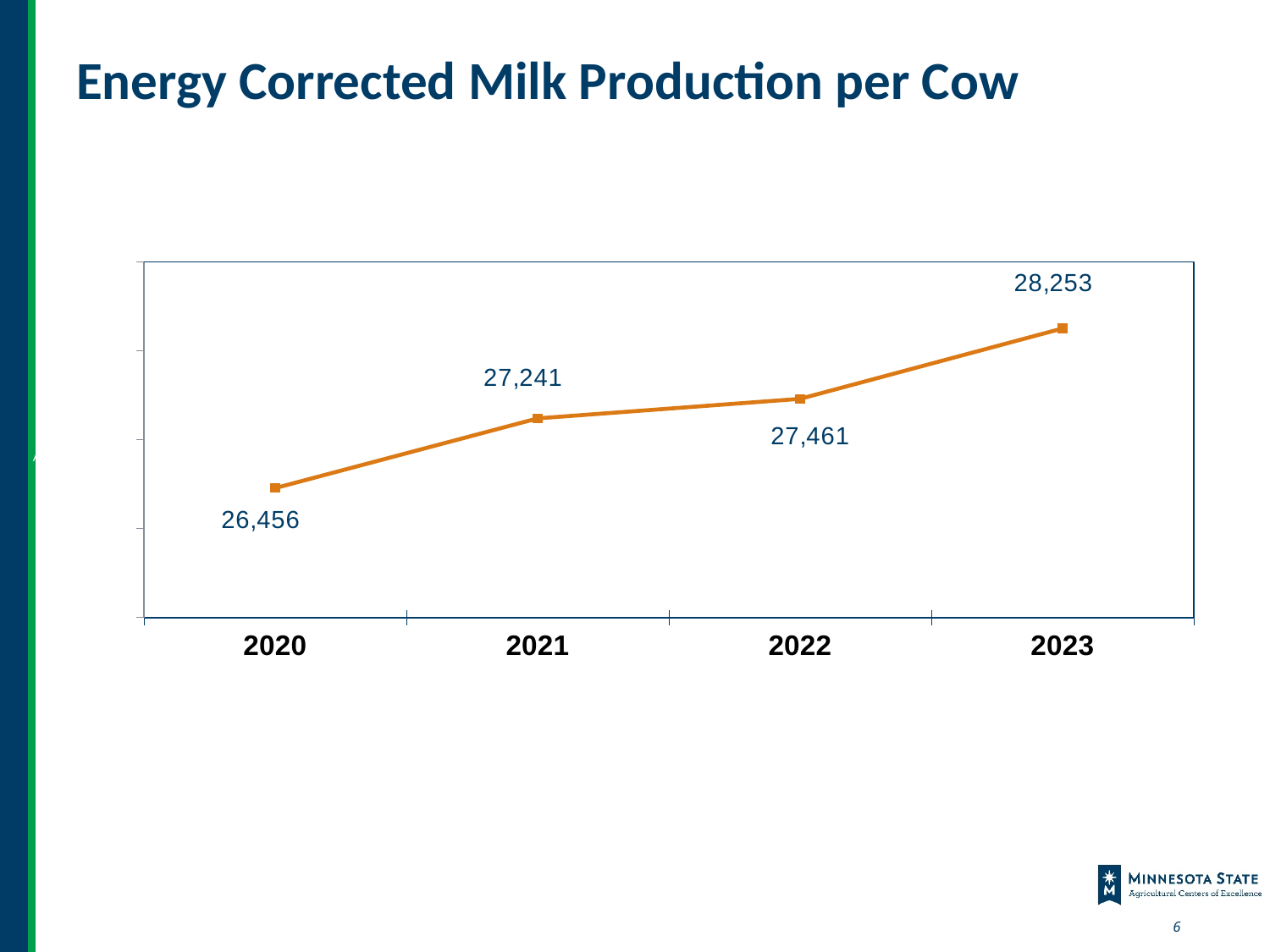
How many years are plotted on the chart? 4 What is the energy corrected milk production per cow in 2020? 26,456 What is the energy corrected milk production per cow in 2023? 28,253 What is the difference in energy corrected milk production per cow between 2023 and 2020? 1,797 What is the energy corrected milk production per cow in 2022? 27,461 What is the difference in energy corrected milk production per cow between 2022 and 2021? 220 Which year has the lowest energy corrected milk production per cow? 2020 What is the energy corrected milk production per cow in 2021? 27,241 What kind of chart is shown on the slide? Line chart Is the energy corrected milk production per cow higher in 2021 or in 2022? 2022 Which year has the highest energy corrected milk production per cow? 2023 Does energy corrected milk production per cow rise or fall from 2020 to 2023? Rise